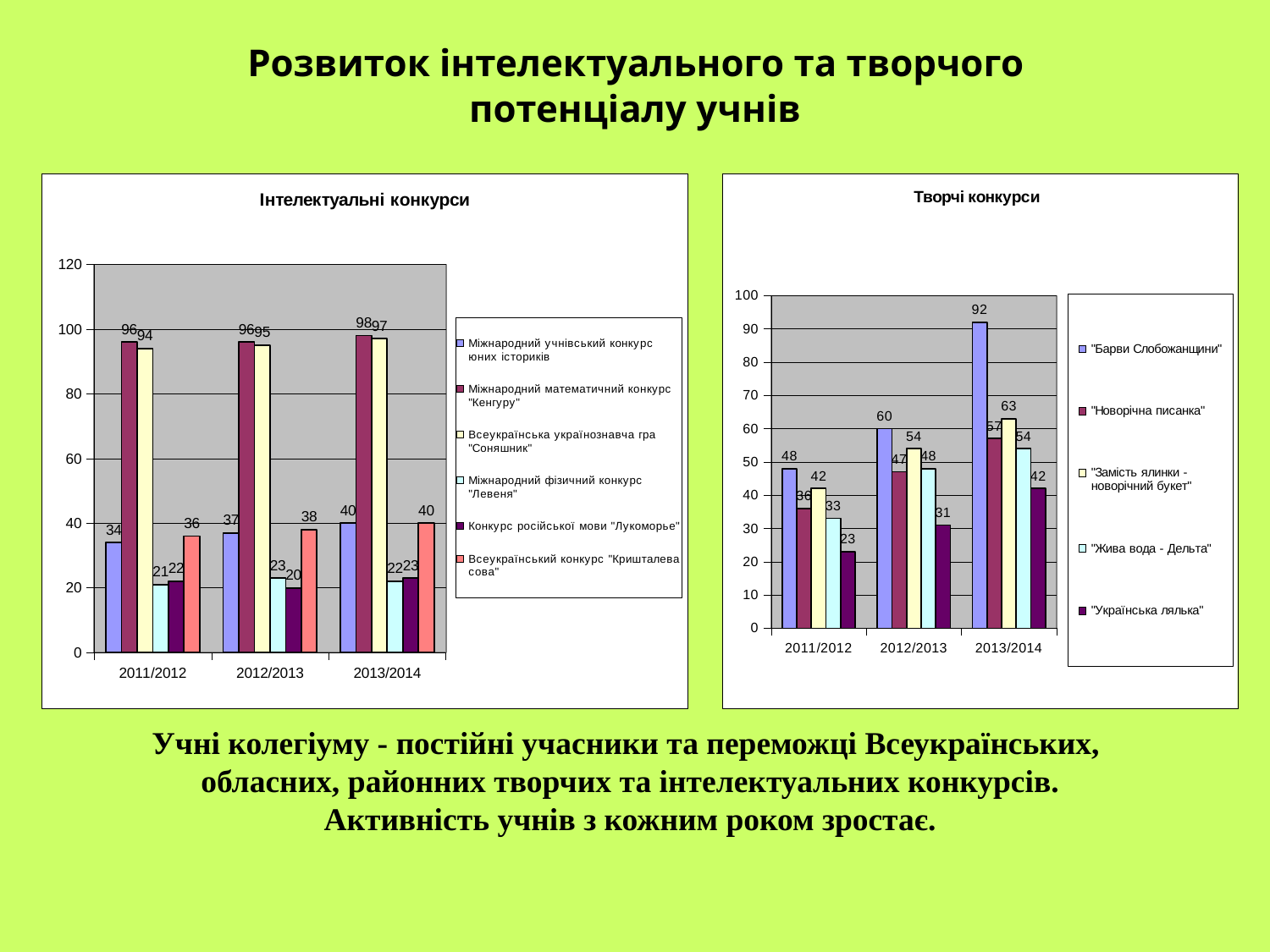
In the chart titled "Інтелектуальні конкурси", does the value for "Міжнародний учнівський конкурс юних істориків" rise or fall from 2011/2012 to 2013/2014? rise In the chart titled "Інтелектуальні конкурси", what is the value for "Міжнародний математичний конкурс "Кенгуру"" in 2013/2014? 98 In the chart titled "Інтелектуальні конкурси", what is the value for "Міжнародний учнівський конкурс юних істориків" in 2011/2012? 34 In the chart titled "Творчі конкурси", which series has the lowest value in 2011/2012? "Українська лялька" What kind of chart is the chart titled "Творчі конкурси"? bar chart In the chart titled "Інтелектуальні конкурси", what is the difference between "Всеукраїнська українознавча гра "Соняшник"" in 2013/2014 and in 2011/2012? 3 In the chart titled "Творчі конкурси", how many categories are shown on the x axis? 3 In the chart titled "Творчі конкурси", which series has the highest value in 2012/2013? "Барви Слобожанщини" In the chart titled "Творчі конкурси", what is the value for "Барви Слобожанщини" in 2013/2014? 92 In the chart titled "Творчі конкурси", which is larger in 2013/2014: "Новорічна писанка" or "Замість ялинки - новорічний букет"? "Замість ялинки - новорічний букет" In the chart titled "Творчі конкурси", what is the difference between "Барви Слобожанщини" in 2013/2014 and in 2012/2013? 32 In the chart titled "Інтелектуальні конкурси", how many series does the legend list? 6